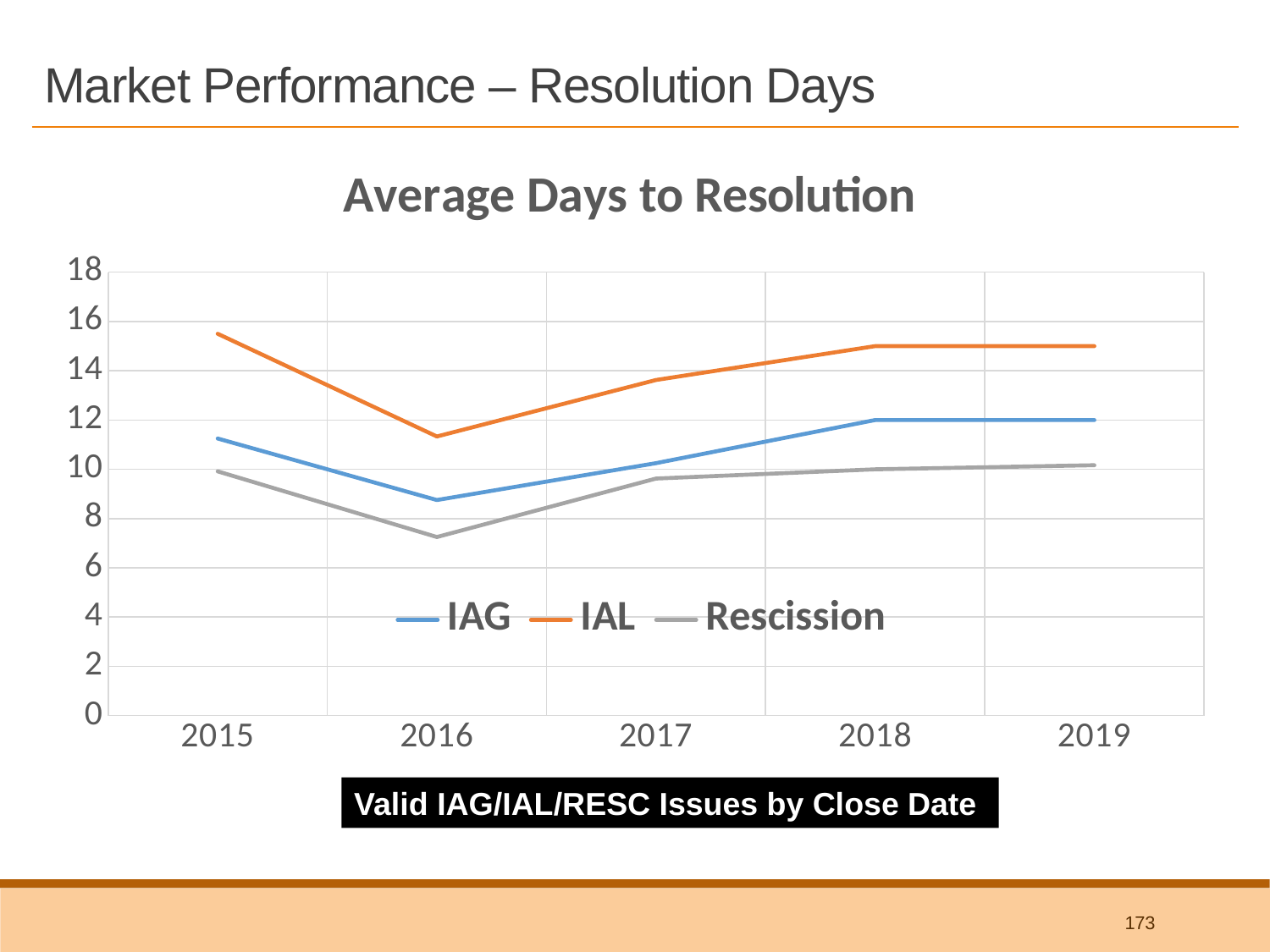
Which series is drawn in orange? IAL Is the value for IAG in 2016 greater or less than 10? less Is the value for Rescission in 2016 greater or less than 8? less How many years are plotted along the x axis? 5 How many series does the legend list? 3 In which year does the Rescission series reach its lowest value? 2016 What type of chart is shown on the slide? line chart Is the value for IAL in 2015 greater or less than 14? greater In which year does the IAL series reach its highest value? 2015 What is the title of the chart? Average Days to Resolution Which series has the larger value in 2017, IAG or IAL? IAL Does the IAL series rise or fall from 2016 to 2018? rise